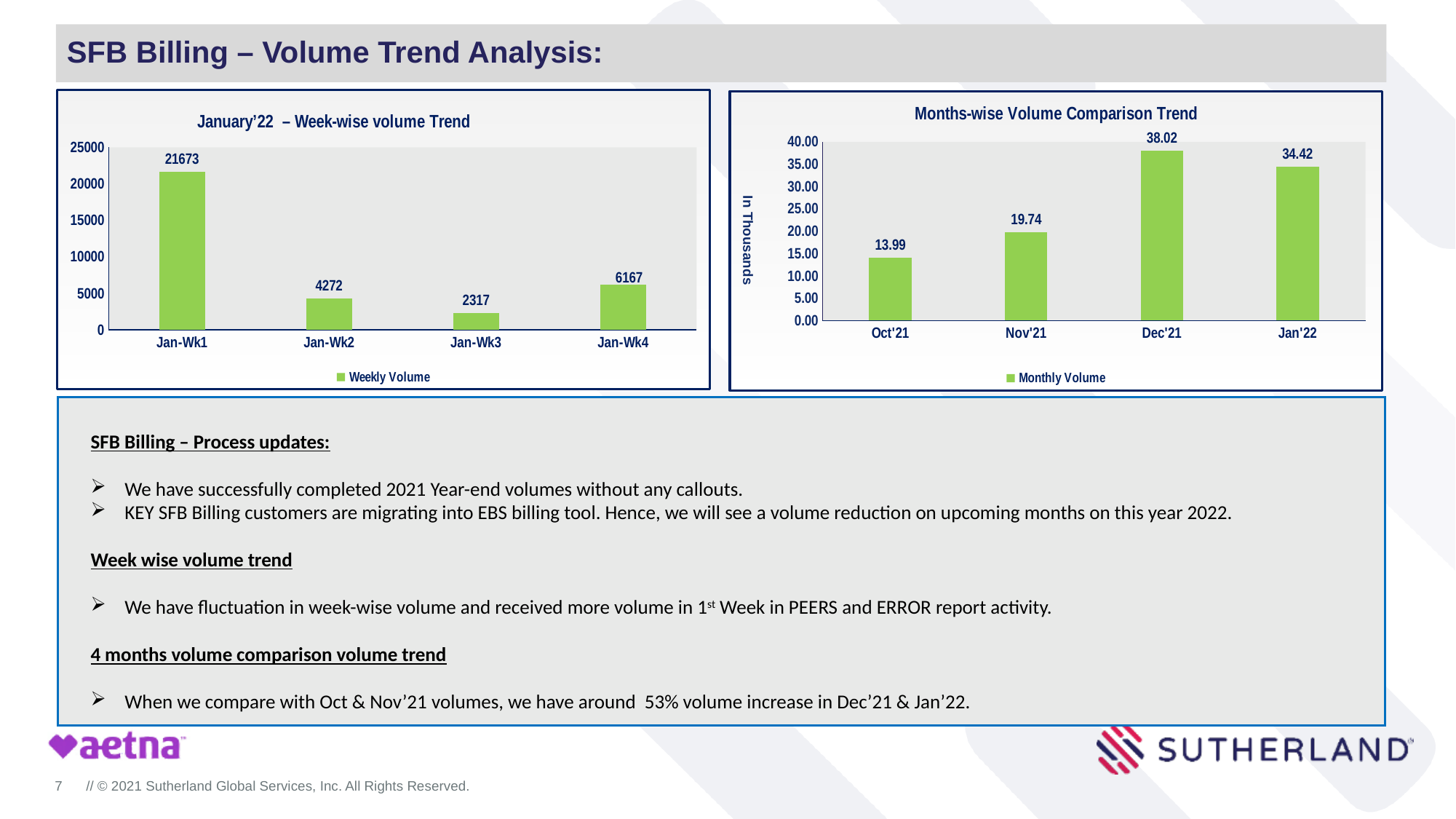
In the 'Months-wise Volume Comparison Trend' chart, what is the y-axis label? In Thousands In the 'January'22 – Week-wise volume Trend' chart, how many weeks are plotted? 4 In the 'Months-wise Volume Comparison Trend' chart, what is the difference between Dec'21 and Jan'22? 3.60 In the 'January'22 – Week-wise volume Trend' chart, what is the difference between Jan-Wk4 and Jan-Wk2? 1895 In the 'January'22 – Week-wise volume Trend' chart, what series name does the legend show? Weekly Volume In the 'January'22 – Week-wise volume Trend' chart, which week has the lowest volume? Jan-Wk3 In the 'January'22 – Week-wise volume Trend' chart, what is the value for Jan-Wk1? 21673 What kind of chart is the 'Months-wise Volume Comparison Trend' chart? Bar chart In the 'Months-wise Volume Comparison Trend' chart, what is the value for Nov'21? 19.74 In the 'Months-wise Volume Comparison Trend' chart, which is larger, Oct'21 or Jan'22? Jan'22 In the 'Months-wise Volume Comparison Trend' chart, which month has the highest volume? Dec'21 In the 'January'22 – Week-wise volume Trend' chart, is the value for Jan-Wk4 greater or less than 5000? greater